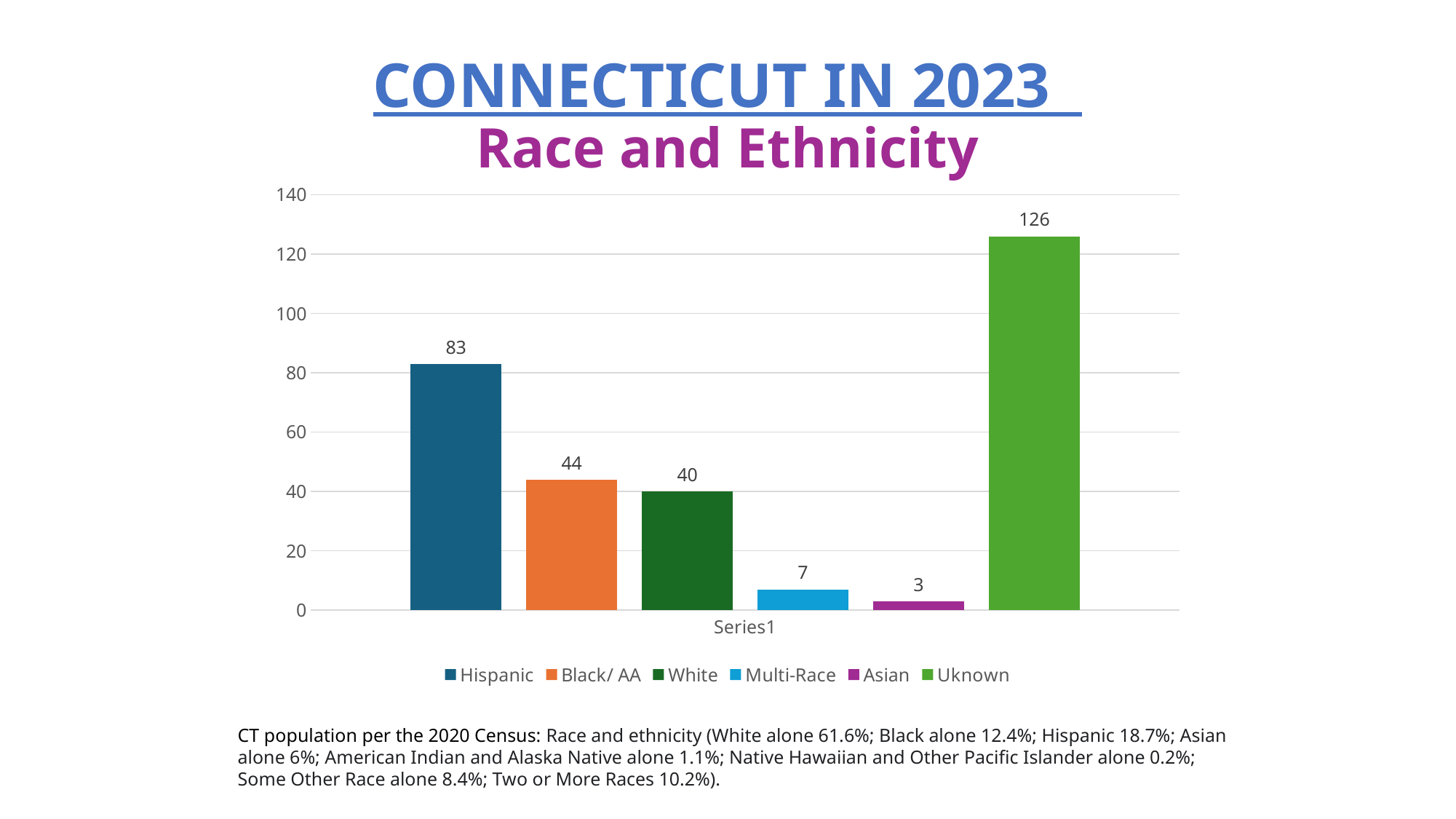
Which category has the lowest value? Asian What colour is the bar for Asian? Purple What is the value for Multi-Race? 7 What kind of chart is shown on the slide? Bar chart Is the value for Uknown greater or less than 120? greater Which category has the highest value? Uknown Which is larger, the value for Black/ AA or the value for White? Black/ AA How many categories are shown in the legend? 6 What is the value for Black/ AA? 44 What is the difference between the values for Hispanic and White? 43 What is the value for Uknown? 126 What is the value for Hispanic? 83